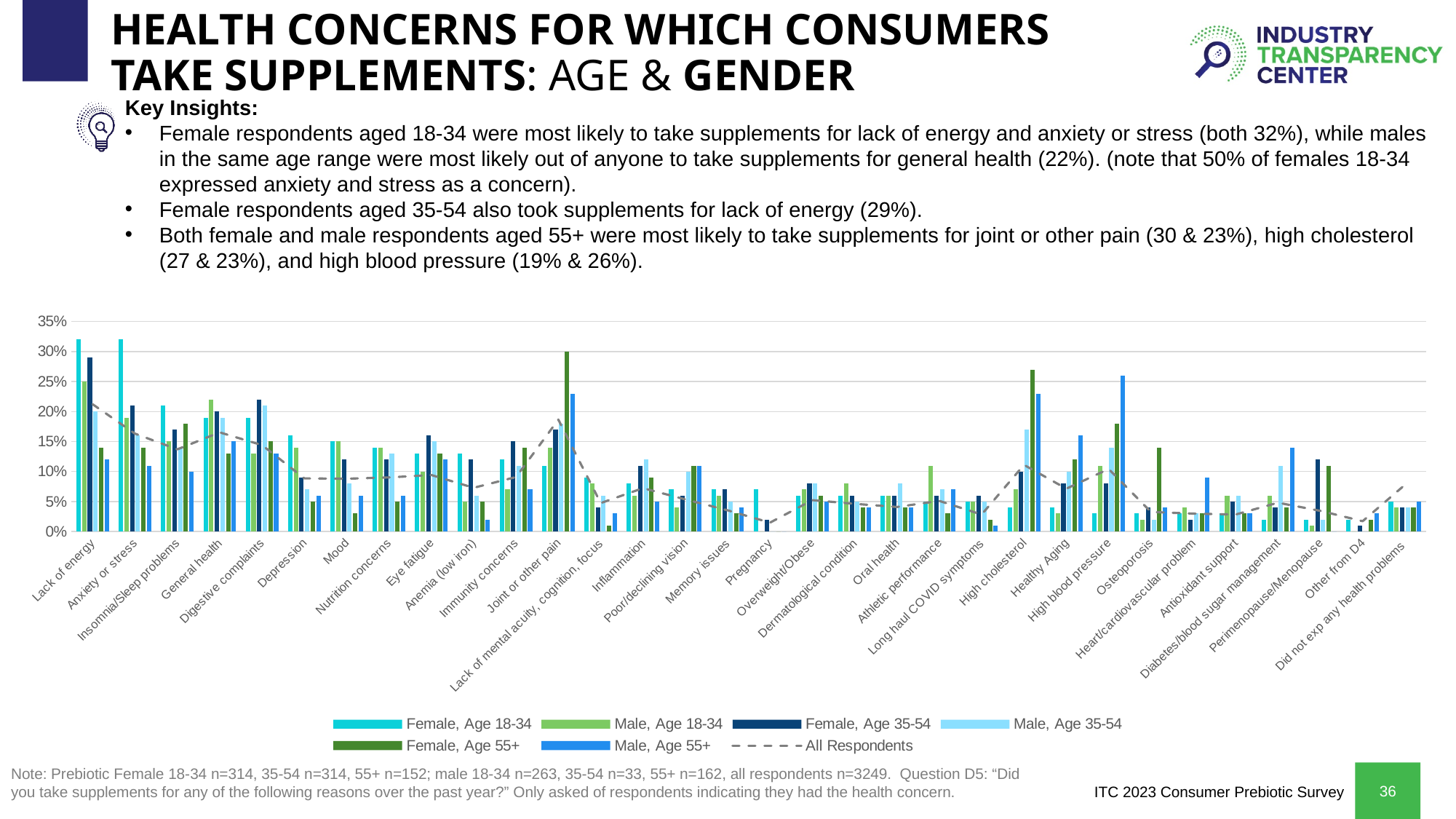
What is the value for Female, Age 55+ for Joint or other pain? 30% For Joint or other pain, which is larger: the value for Female, Age 55+ or Male, Age 55+? Female, Age 55+ Which series has the highest bar for High blood pressure? Male, Age 55+ Which series has the highest bar for Joint or other pain? Female, Age 55+ What kind of chart is shown on the slide? combination bar and line chart How many series does the chart's legend list? 7 For High cholesterol, which is larger: the value for Female, Age 55+ or Male, Age 55+? Female, Age 55+ Is the value for Female, Age 18-34 for Pregnancy greater or less than 10%? less Is the value for Male, Age 55+ for High blood pressure greater or less than 20%? greater How many health concern categories are shown along the x axis of the chart? 32 Is the value for Female, Age 18-34 for Lack of energy greater or less than 30%? greater What does the dashed grey line in the chart represent? All Respondents